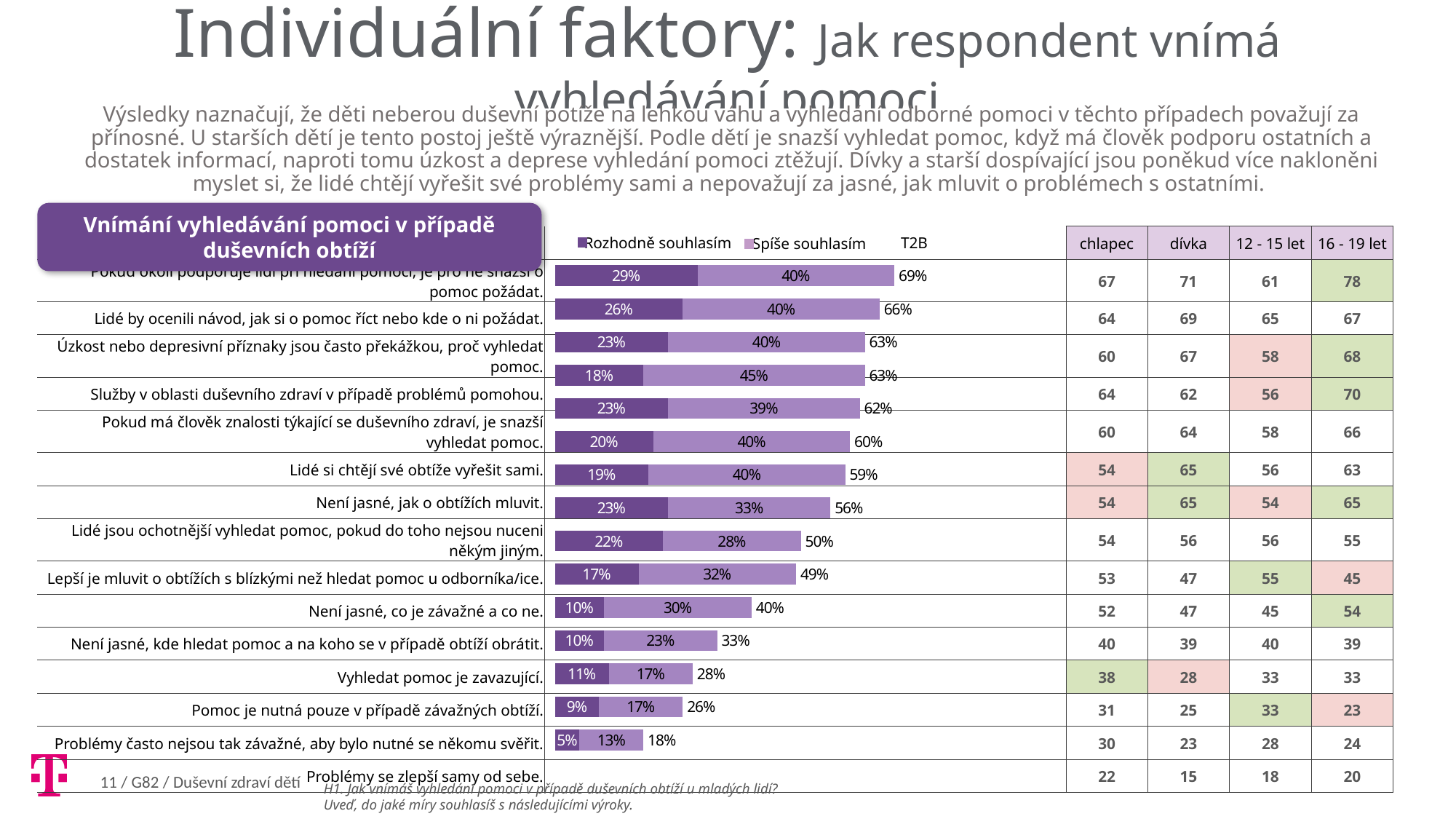
What is the T2B value for the top bar, 'Pokud okolí podporuje lidi při hledání pomoci, je pro ně snazší o pomoc požádat.'? 69% Which statement has the highest T2B value? Pokud okolí podporuje lidi při hledání pomoci, je pro ně snazší o pomoc požádat. How many statements (bars) are plotted in the chart? 15 Which statement has the lowest T2B value? Problémy se zlepší samy od sebe. What kind of chart is shown on the slide? Stacked bar chart What is the 'Rozhodně souhlasím' value for the bottom bar, 'Problémy se zlepší samy od sebe.'? 5% Which is larger: the T2B value of the top bar (69%) or the T2B value of the second bar (66%)? The top bar (69%) What is the difference between the highest T2B value (69%) and the lowest T2B value (18%)? 51% What is the title shown in the purple box above the chart? Vnímání vyhledávání pomoci v případě duševních obtíží What is the 'Spíše souhlasím' value for the bottom bar, 'Problémy se zlepší samy od sebe.'? 13% How many series does the chart legend list? 2 What is the 'Rozhodně souhlasím' value for the second bar, 'Lidé by ocenili návod, jak si o pomoc říct nebo kde o ni požádat.'? 26%